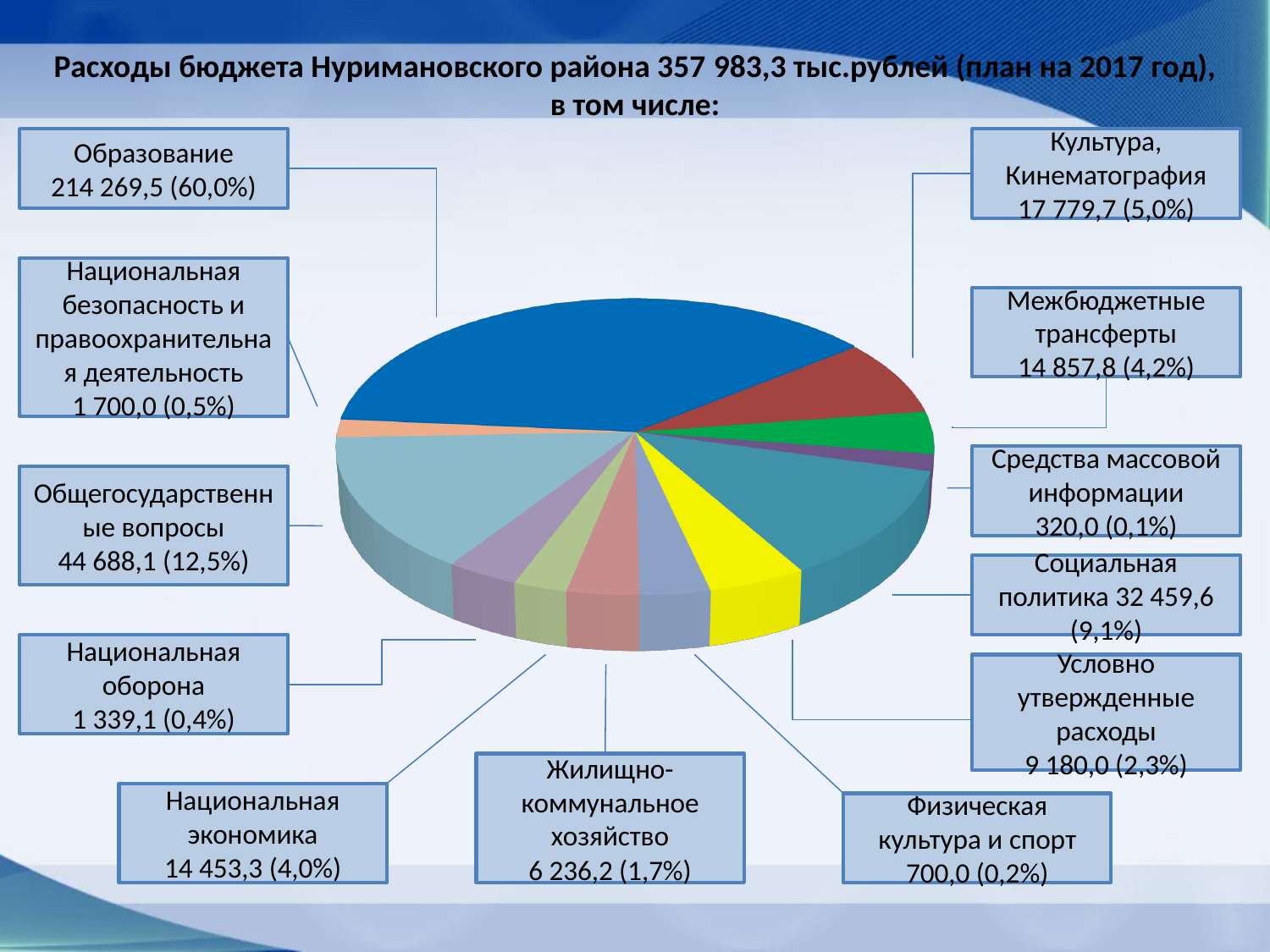
What is the difference in percentage share between Социальная политика and Условно утвержденные расходы? 6,8% Which category has the largest share of the budget? Образование What share of the budget goes to Культура, Кинематография? 5,0% Which category has the smallest share of the budget? Средства массовой информации What is the value for Социальная политика? 32 459,6 (9,1%) What total budget expenditure is stated in the slide title? 357 983,3 тыс.рублей Which is larger: Межбюджетные трансферты or Национальная экономика? Межбюджетные трансферты What kind of chart is shown on the slide? Pie chart What share of the budget goes to Общегосударственные вопросы? 12,5% How many expenditure categories are shown in the pie chart? 12 What is the planned expenditure for Образование (education)? 214 269,5 (60,0%) What is the value for Жилищно-коммунальное хозяйство? 6 236,2 (1,7%)